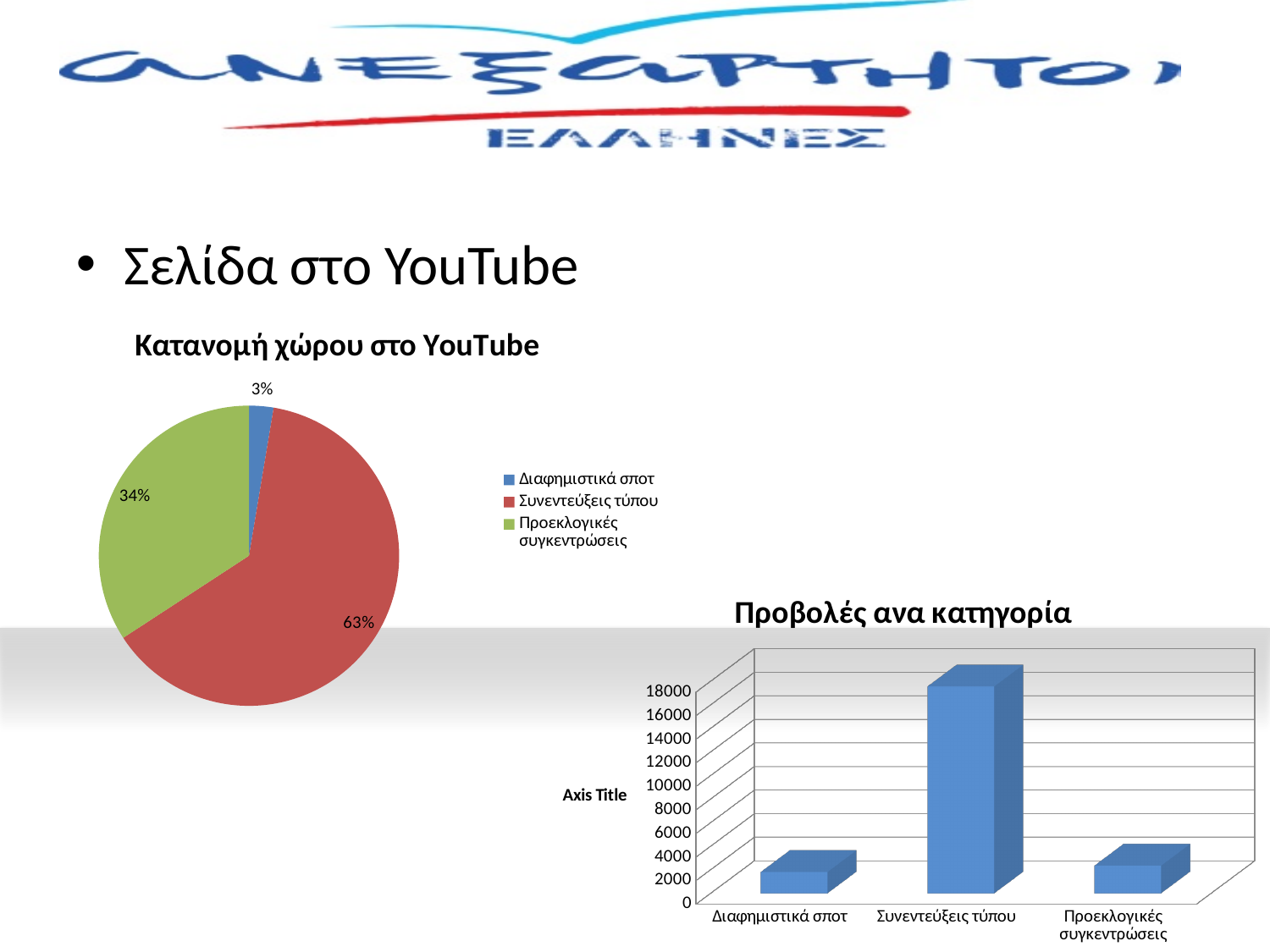
In the chart titled "Προβολές ανα κατηγορία", is the value for Διαφημιστικά σποτ greater or less than 6000? less In the chart titled "Κατανομή χώρου στο YouTube", what share of the pie does Προεκλογικές συγκεντρώσεις have? 34% What kind of chart is the one titled "Προβολές ανα κατηγορία"? Bar chart How many categories does the legend of the chart titled "Κατανομή χώρου στο YouTube" list? 3 In the chart titled "Κατανομή χώρου στο YouTube", which category has the smallest slice? Διαφημιστικά σποτ In the chart titled "Κατανομή χώρου στο YouTube", which category has the largest slice? Συνεντεύξεις τύπου In the chart titled "Κατανομή χώρου στο YouTube", what share of the pie does Συνεντεύξεις τύπου have? 63% In the chart titled "Προβολές ανα κατηγορία", is the value for Συνεντεύξεις τύπου greater or less than 14000? greater What kind of chart is the one titled "Κατανομή χώρου στο YouTube"? Pie chart In the chart titled "Κατανομή χώρου στο YouTube", what is the difference between the shares of Συνεντεύξεις τύπου and Προεκλογικές συγκεντρώσεις? 29% In the chart titled "Προβολές ανα κατηγορία", which category has the highest bar? Συνεντεύξεις τύπου In the chart titled "Κατανομή χώρου στο YouTube", what is the value shown for Διαφημιστικά σποτ? 3%